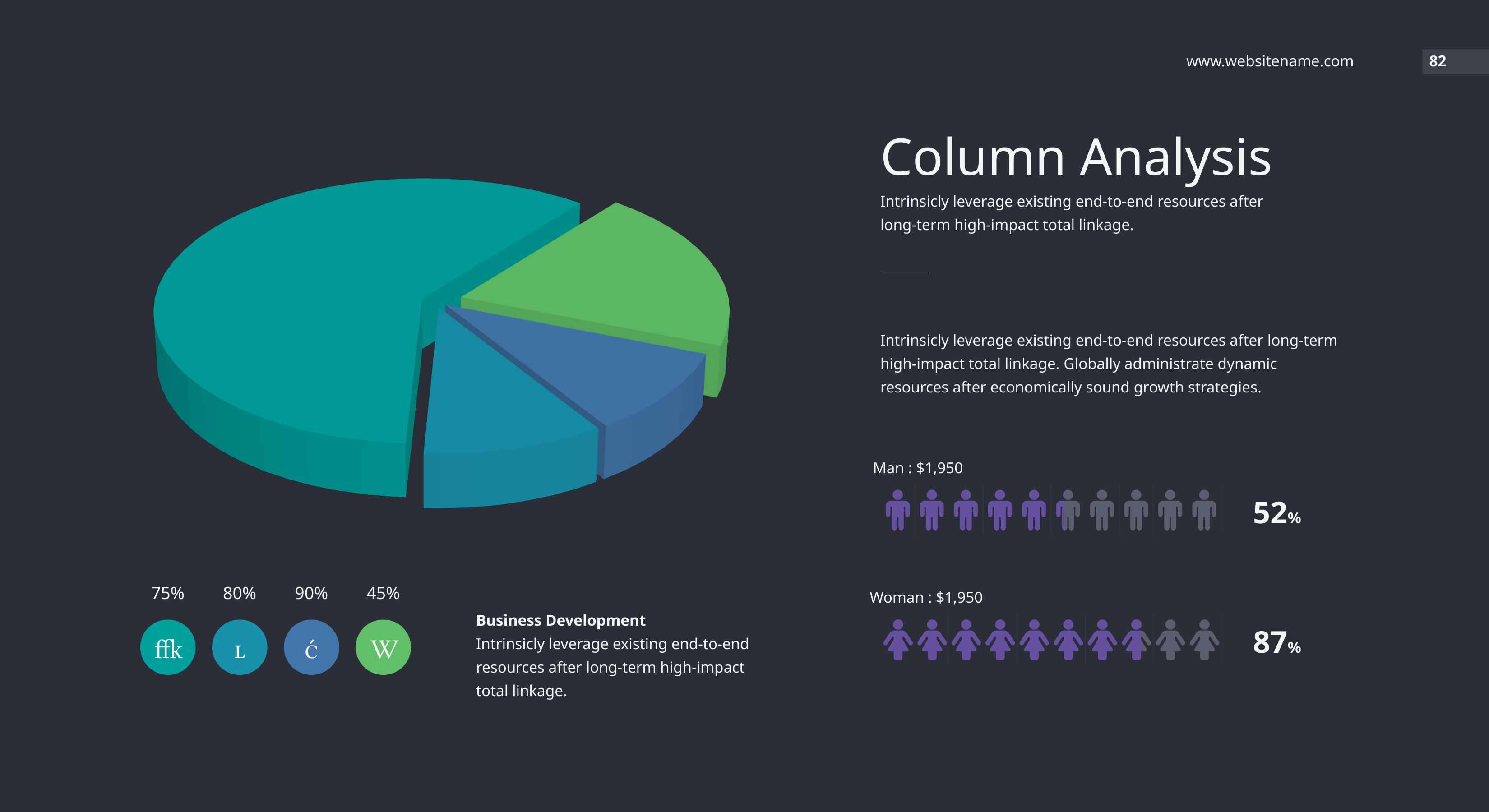
In the pictograph section, what dollar value is shown next to Man? $1,950 What kind of chart is shown on the left of the slide? pie chart In the pictograph section, which has the higher percentage, Man or Woman? Woman In the pictograph section, what percentage is shown for Woman? 87% How many slices does the pie chart have? 4 Which colour slice is the largest in the pie chart? teal Among the four percentages printed below the pie chart, which is the highest? 90% In the pictograph section, what percentage is shown for Man? 52% How many person icons are shown in the Man pictograph row? 10 What percentage is printed above the green circle below the pie chart? 45% In the pictograph section, what is the difference between the Woman percentage and the Man percentage? 35% Among the four percentages printed below the pie chart, which is the lowest? 45%